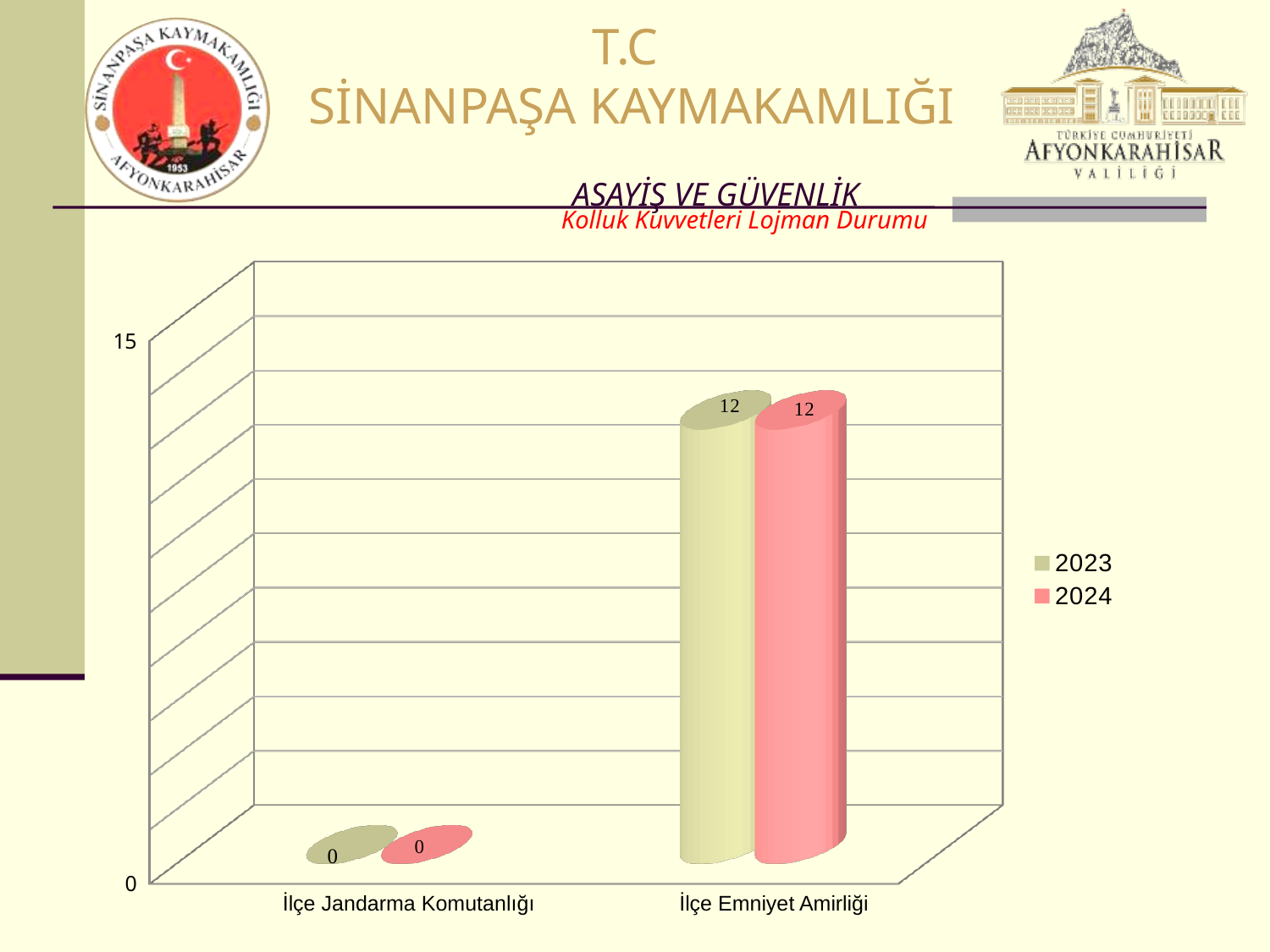
What is the value for İlçe Jandarma Komutanlığı in 2024? 0 What is the value for İlçe Jandarma Komutanlığı in 2023? 0 What kind of chart is shown on the slide? bar chart Which category has the lowest value in 2023? İlçe Jandarma Komutanlığı Is the 2024 value for İlçe Emniyet Amirliği greater or less than 15? less How many categories are shown on the x axis? 2 What is the value for İlçe Emniyet Amirliği in 2023? 12 Which is larger: the 2023 value for İlçe Emniyet Amirliği or the 2023 value for İlçe Jandarma Komutanlığı? İlçe Emniyet Amirliği How many series does the legend list? 2 What is the difference between the 2024 values for İlçe Emniyet Amirliği and İlçe Jandarma Komutanlığı? 12 Which category has the highest value in 2024? İlçe Emniyet Amirliği What is the value for İlçe Emniyet Amirliği in 2024? 12